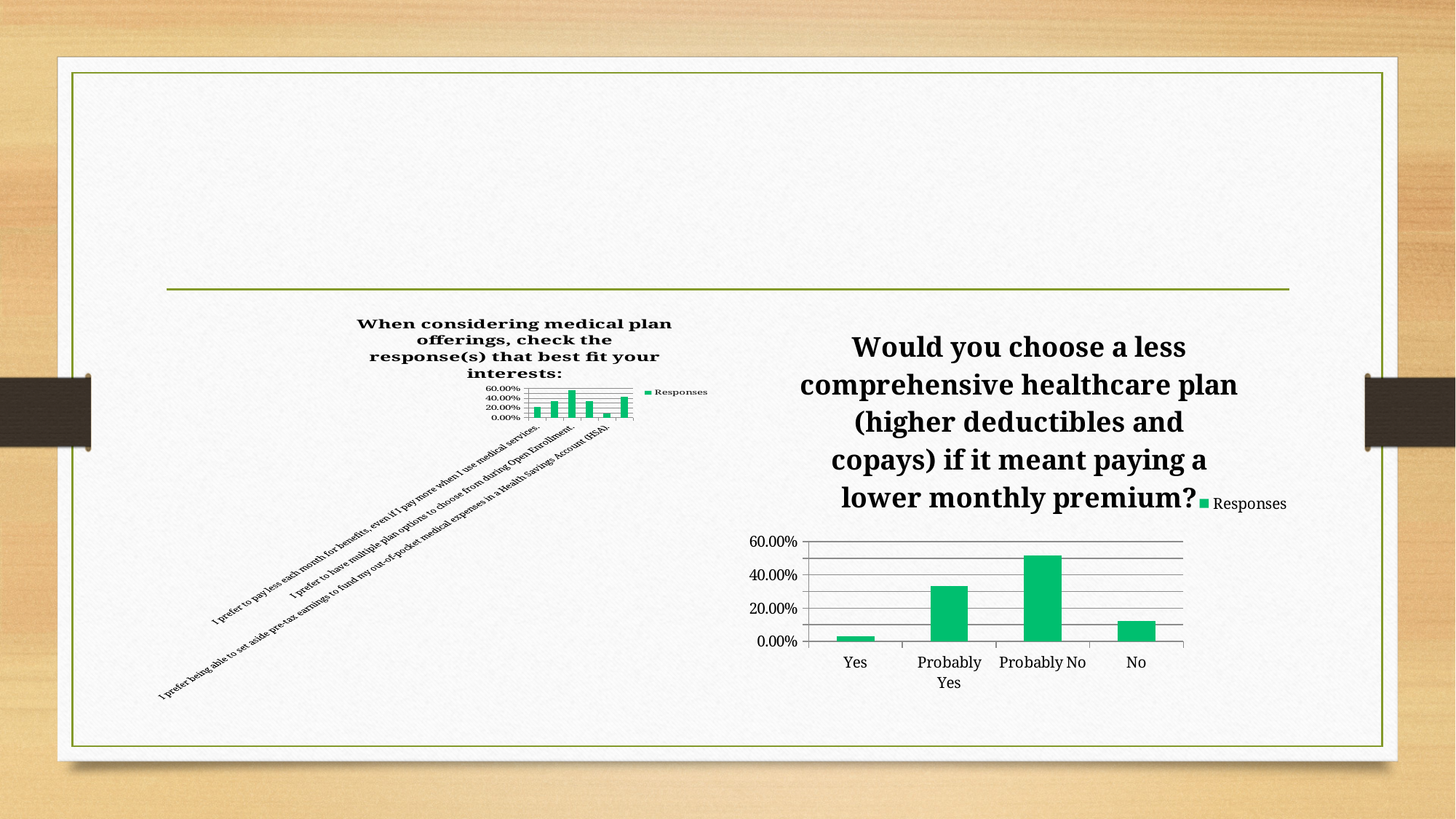
On the right-hand chart, which is larger: the value for Probably Yes or the value for No? Probably Yes On the right-hand chart, is the value for Yes greater or less than 20.00%? less On the chart titled 'Would you choose a less comprehensive healthcare plan...', which response category has the highest value? Probably No On the chart titled 'Would you choose a less comprehensive healthcare plan...', which response category has the lowest value? Yes How many series does the legend of the right-hand chart list? 1 On the right-hand chart, is the value for No greater or less than 20.00%? less How many response categories are shown on the right-hand chart? 4 What kind of chart is the right-hand chart? bar chart What is the legend entry shown on the right-hand chart? Responses On the right-hand chart, is the value for Probably Yes greater or less than 20.00%? greater What kind of chart is the left-hand chart titled 'When considering medical plan offerings...'? bar chart